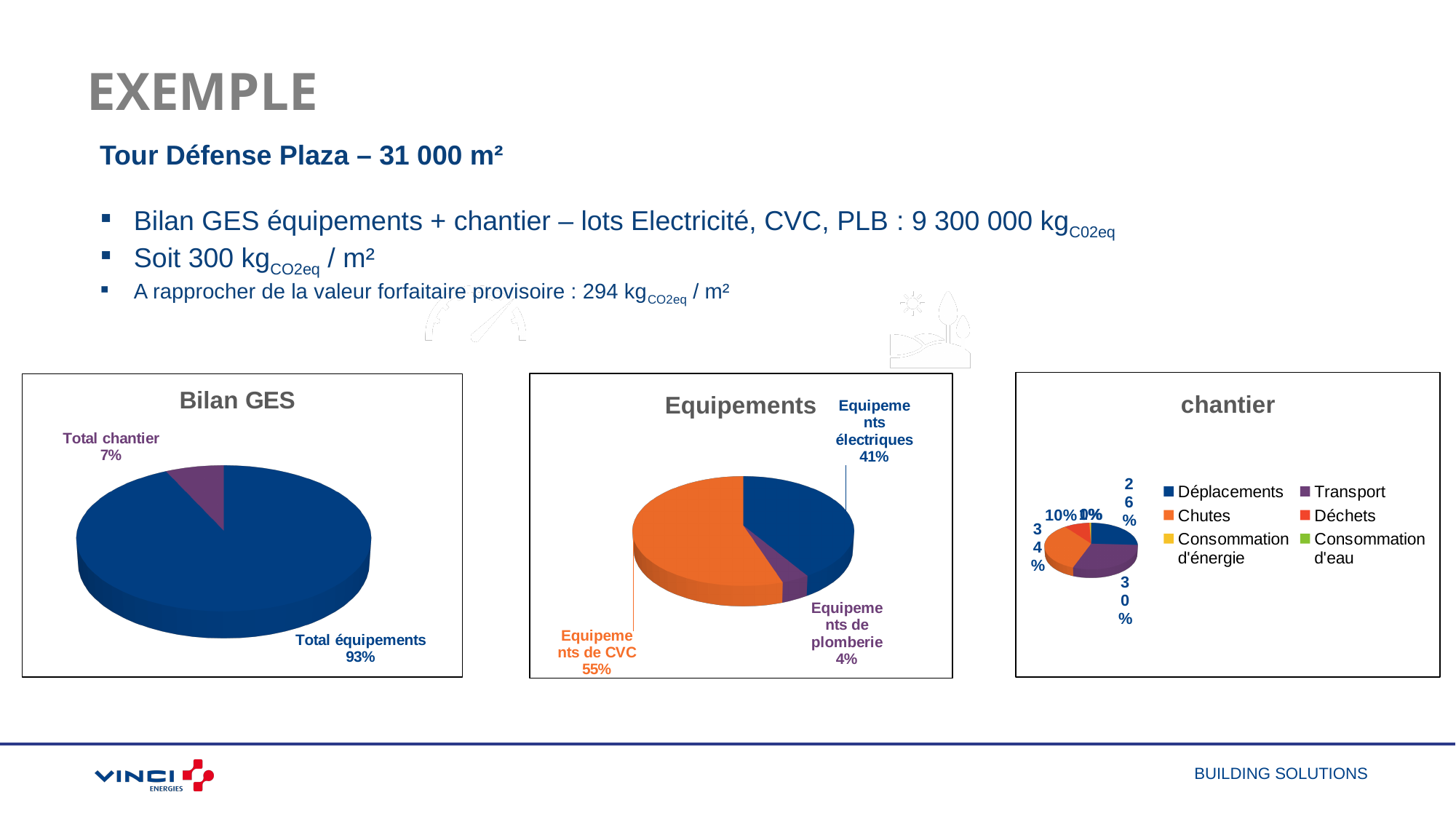
In the Bilan GES chart, what share does Total chantier have? 7% In the Equipements chart, what share do Equipements électriques have? 41% In the Equipements chart, what share do Equipements de CVC have? 55% In the Equipements chart, how many slices are there? 3 What kind of chart is the Bilan GES chart? Pie chart In the Equipements chart, which is larger: Equipements de CVC or Equipements électriques? Equipements de CVC In the Equipements chart, which slice is the smallest? Equipements de plomberie In the chantier chart, how many entries does the legend list? 6 In the Bilan GES chart, which slice is the largest? Total équipements In the Bilan GES chart, what is the difference in percentage points between Total équipements and Total chantier? 86 In the chantier chart, what colour represents Chutes? Orange In the Bilan GES chart, what share does Total équipements have? 93%